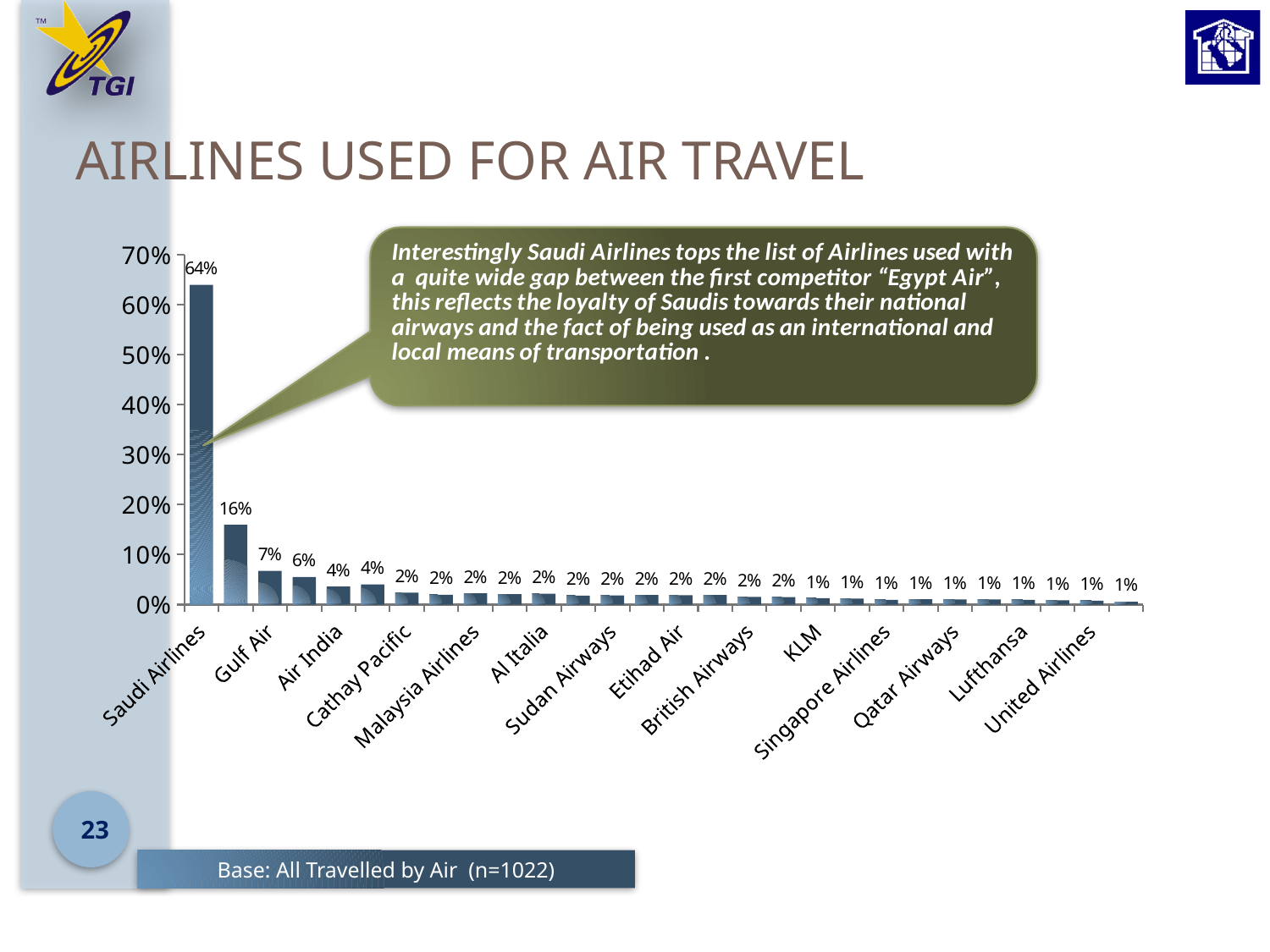
What percentage is shown for Air India? 4% What percentage is shown for KLM? 1% What percentage is shown for Saudi Airlines? 64% Which airline has the highest value in the chart? Saudi Airlines What is the second highest value shown in the chart? 16% What is the difference between the values for Saudi Airlines and Gulf Air? 57% Is the value for Saudi Airlines greater or less than 60%? greater What is the title of the chart on the slide? AIRLINES USED FOR AIR TRAVEL What type of chart is shown on the slide? bar chart Which has a larger value, Gulf Air or Air India? Gulf Air Do the values rise or fall moving from left to right along the x axis? fall What percentage is shown for Gulf Air? 7%